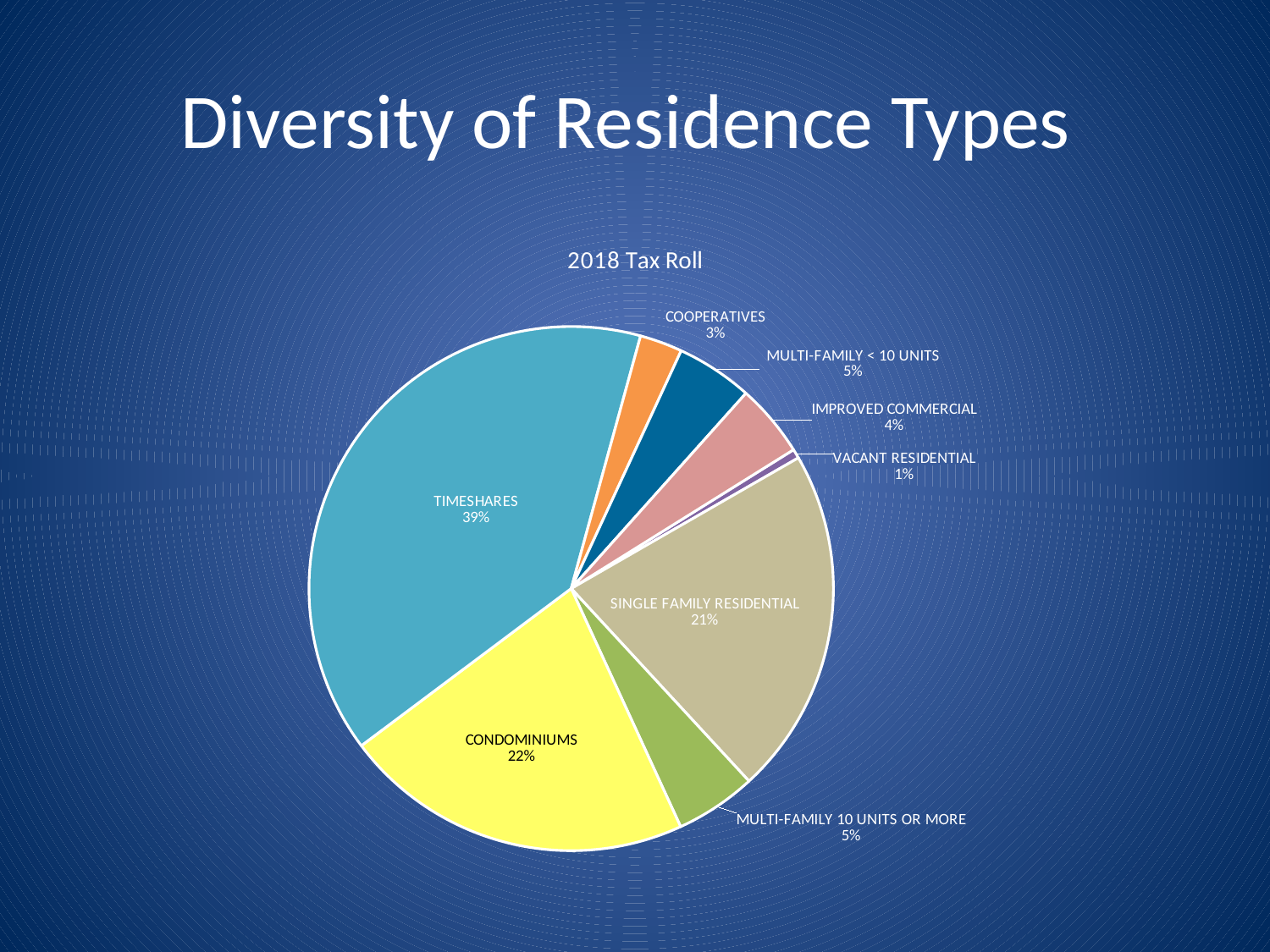
What share of the pie is TIMESHARES? 39% What percentage is shown for SINGLE FAMILY RESIDENTIAL? 21% Which is larger, the share for IMPROVED COMMERCIAL or the share for COOPERATIVES? IMPROVED COMMERCIAL What kind of chart is shown on the slide? pie chart What is the title of the chart? 2018 Tax Roll Which category has the largest slice of the pie? TIMESHARES Which category has the smallest slice of the pie? VACANT RESIDENTIAL How many slices does the pie chart have? 8 What percentage is shown for CONDOMINIUMS? 22% What percentage is shown for MULTI-FAMILY 10 UNITS OR MORE? 5% What percentage is shown for VACANT RESIDENTIAL? 1% What is the difference in percentage points between TIMESHARES and CONDOMINIUMS? 17